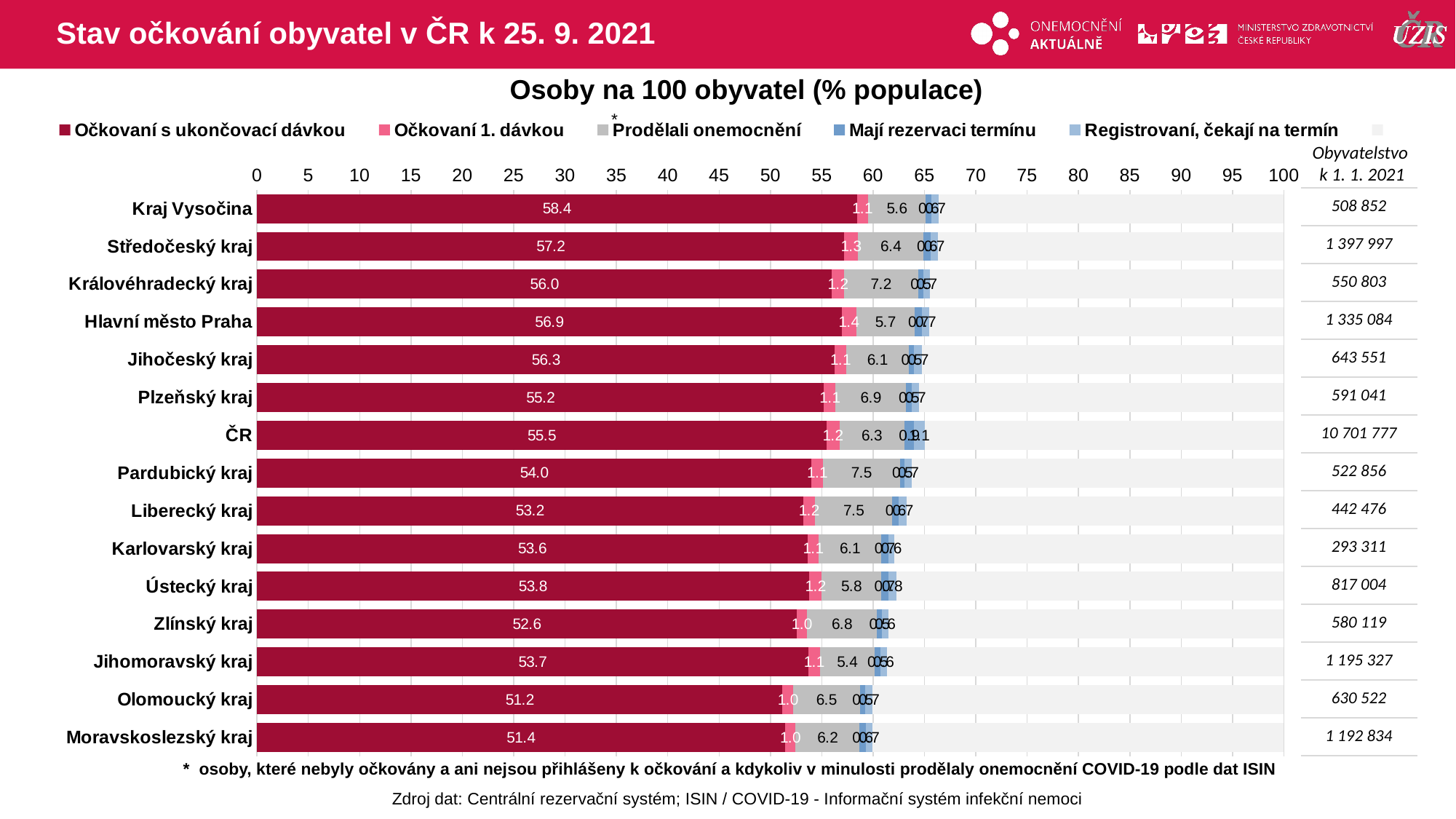
What is the difference between the 'Očkovaní s ukončovací dávkou' values for Kraj Vysočina and Olomoucký kraj? 7.2 What is the value of 'Očkovaní 1. dávkou' for Hlavní město Praha? 1.4 What is the value of 'Prodělali onemocnění' for Pardubický kraj? 7.5 Is the 'Očkovaní s ukončovací dávkou' value for Moravskoslezský kraj greater or less than 55? less What is the title of the chart? Osoby na 100 obyvatel (% populace) Which category has the lowest value for 'Očkovaní s ukončovací dávkou'? Olomoucký kraj Which has a larger 'Očkovaní s ukončovací dávkou' value, Hlavní město Praha or Královéhradecký kraj? Hlavní město Praha How many categories (rows) are plotted in the chart? 15 What type of chart is shown on the slide? Stacked bar chart Which category has the highest value for 'Očkovaní s ukončovací dávkou'? Kraj Vysočina Which category has the lowest value for 'Prodělali onemocnění'? Jihomoravský kraj What is the value of 'Očkovaní s ukončovací dávkou' for Kraj Vysočina? 58.4